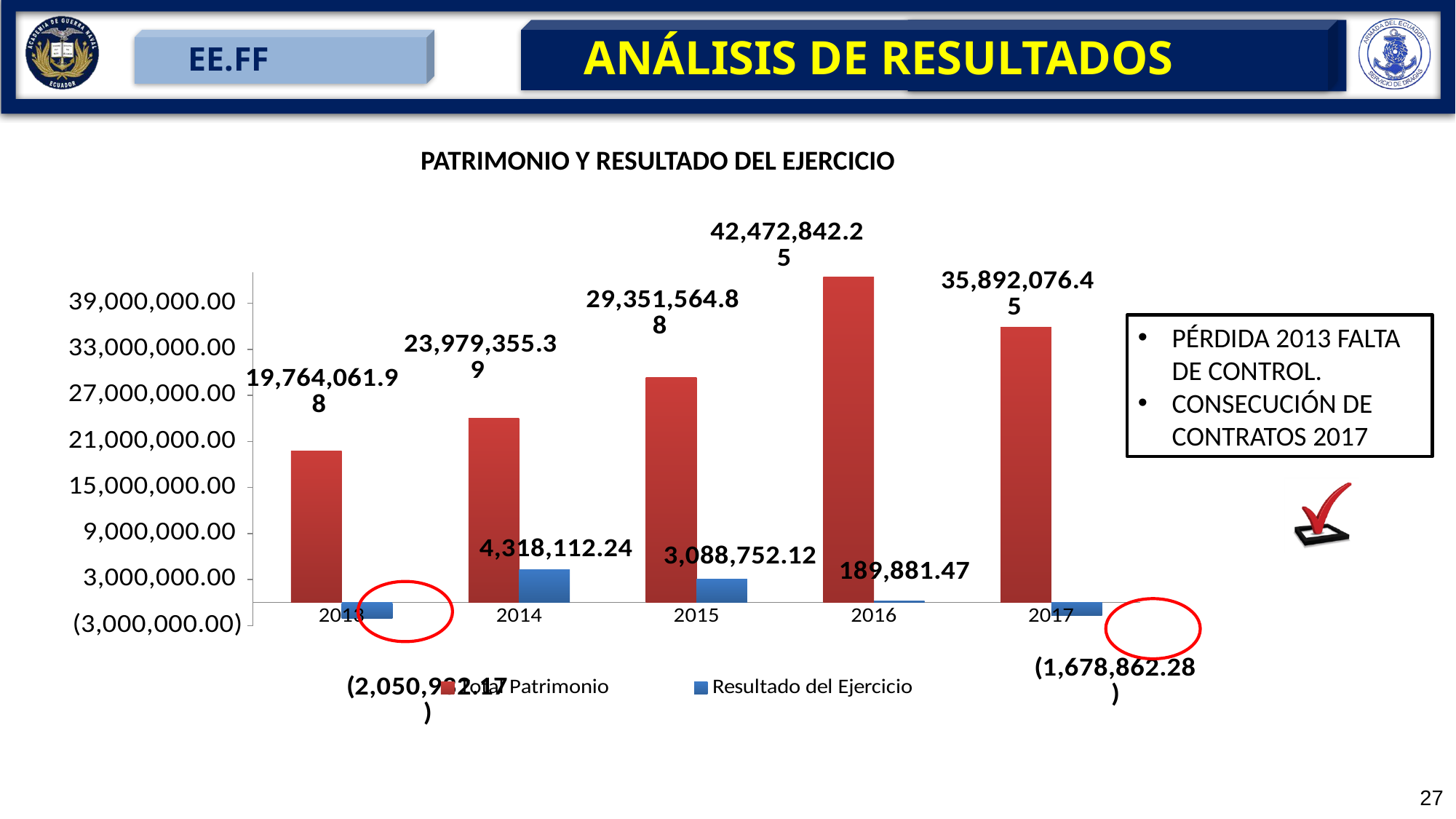
Which year has the larger Resultado del Ejercicio, 2014 or 2015? 2014 How many series does the legend list? 2 What is the difference between Total Patrimonio in 2016 and in 2017? 6,580,765.80 How many years are shown on the x axis? 5 What is the Resultado del Ejercicio value for 2017? (1,678,862.28) In which year is Resultado del Ejercicio highest? 2014 In which year is Total Patrimonio lowest? 2013 In which year is Total Patrimonio highest? 2016 What is the Resultado del Ejercicio value for 2014? 4,318,112.24 What is the Total Patrimonio value for 2016? 42,472,842.25 What kind of chart is shown on the slide? Bar chart Does Total Patrimonio rise or fall from 2013 to 2016? Rises